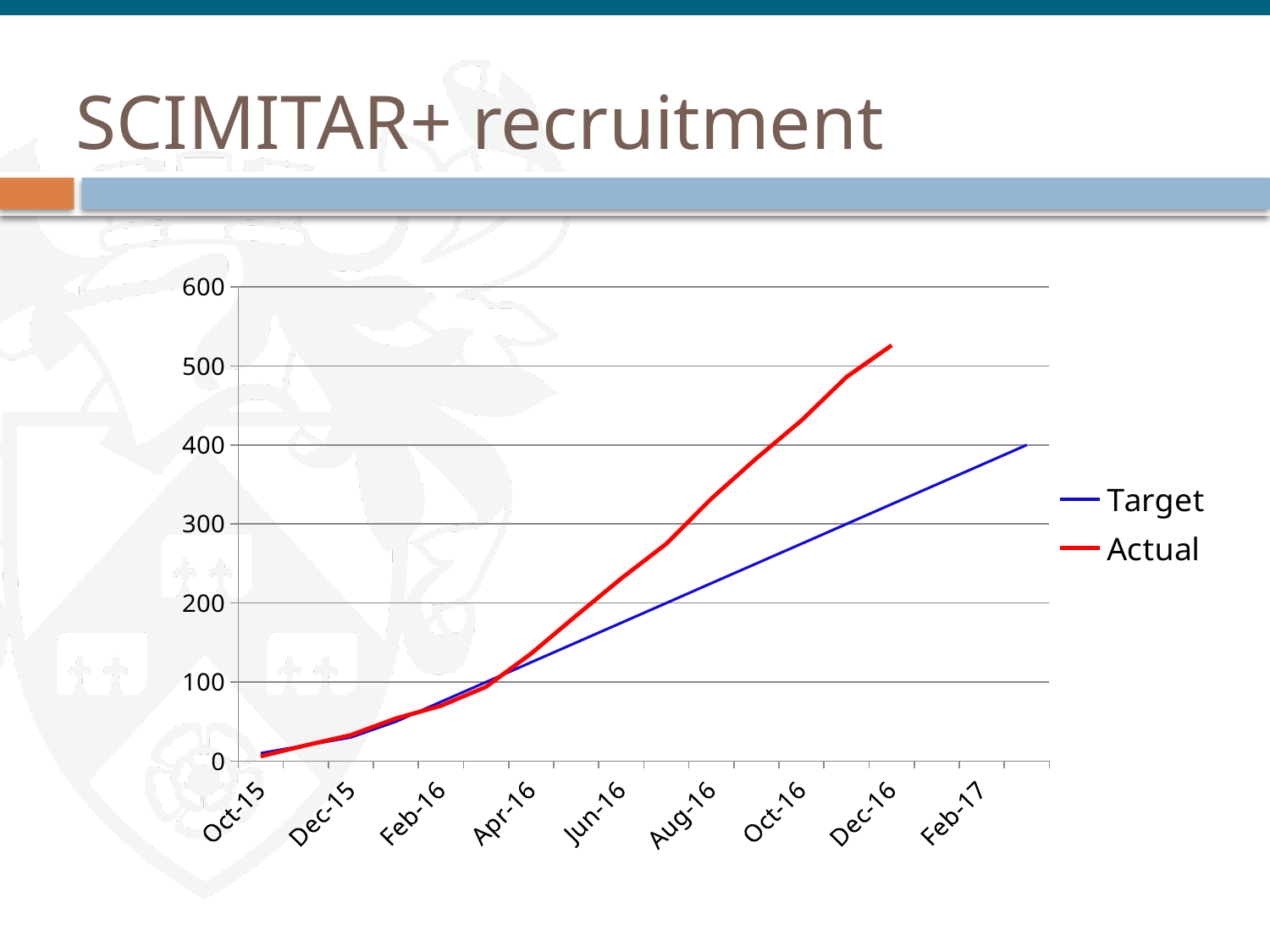
Is the Target value at Dec-16 greater or less than 300? greater Which colour is used for the Actual series? red Is the Actual value at Aug-16 greater or less than 300? greater Is the Target value at Oct-16 greater or less than 300? less Does the Actual line rise or fall from Oct-15 to Dec-16? rise What kind of chart is shown on the slide? line chart How many month labels are shown on the x axis? 9 How many series does the legend list? 2 At Oct-16, which series has the higher value, Target or Actual? Actual At Dec-16, which series has the higher value, Target or Actual? Actual What are the two series named in the legend? Target and Actual